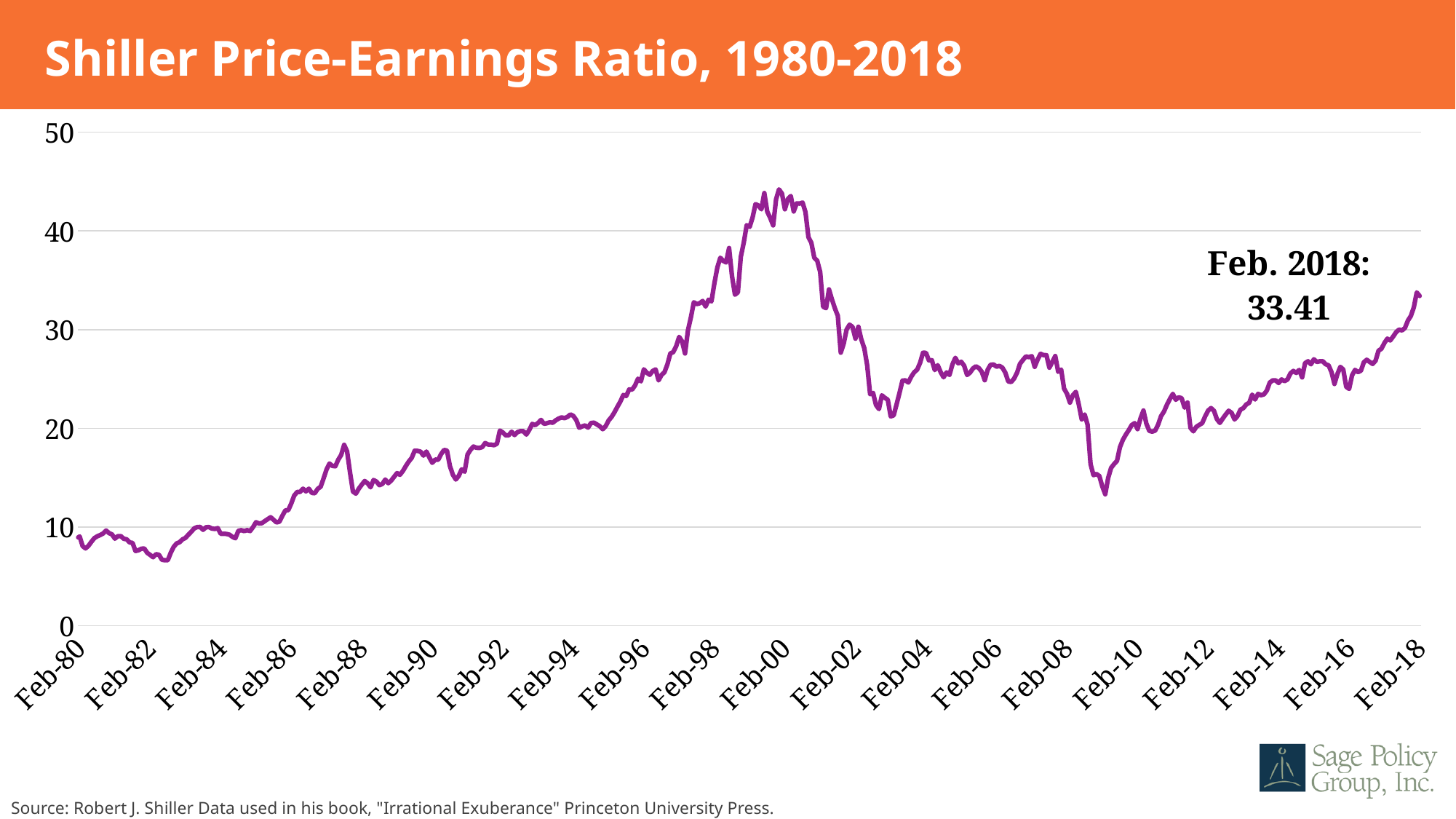
Which is larger, the value at Feb-82 or the value at Feb-92? Feb-92 What is the title of the chart? Shiller Price-Earnings Ratio, 1980-2018 Is the value for Feb-06 greater or less than 20? greater Around which x-axis label does the line reach its highest point? Feb-00 Is the value for Feb-88 greater or less than 20? less Is the value for Feb-00 greater or less than 40? greater What kind of chart is shown on the slide? line chart Does the line generally rise or fall between Feb-80 and Feb-00? rise What is the Shiller Price-Earnings Ratio for Feb. 2018 as labeled on the chart? 33.41 Which is larger, the value at Feb-00 or the value at Feb-18? Feb-00